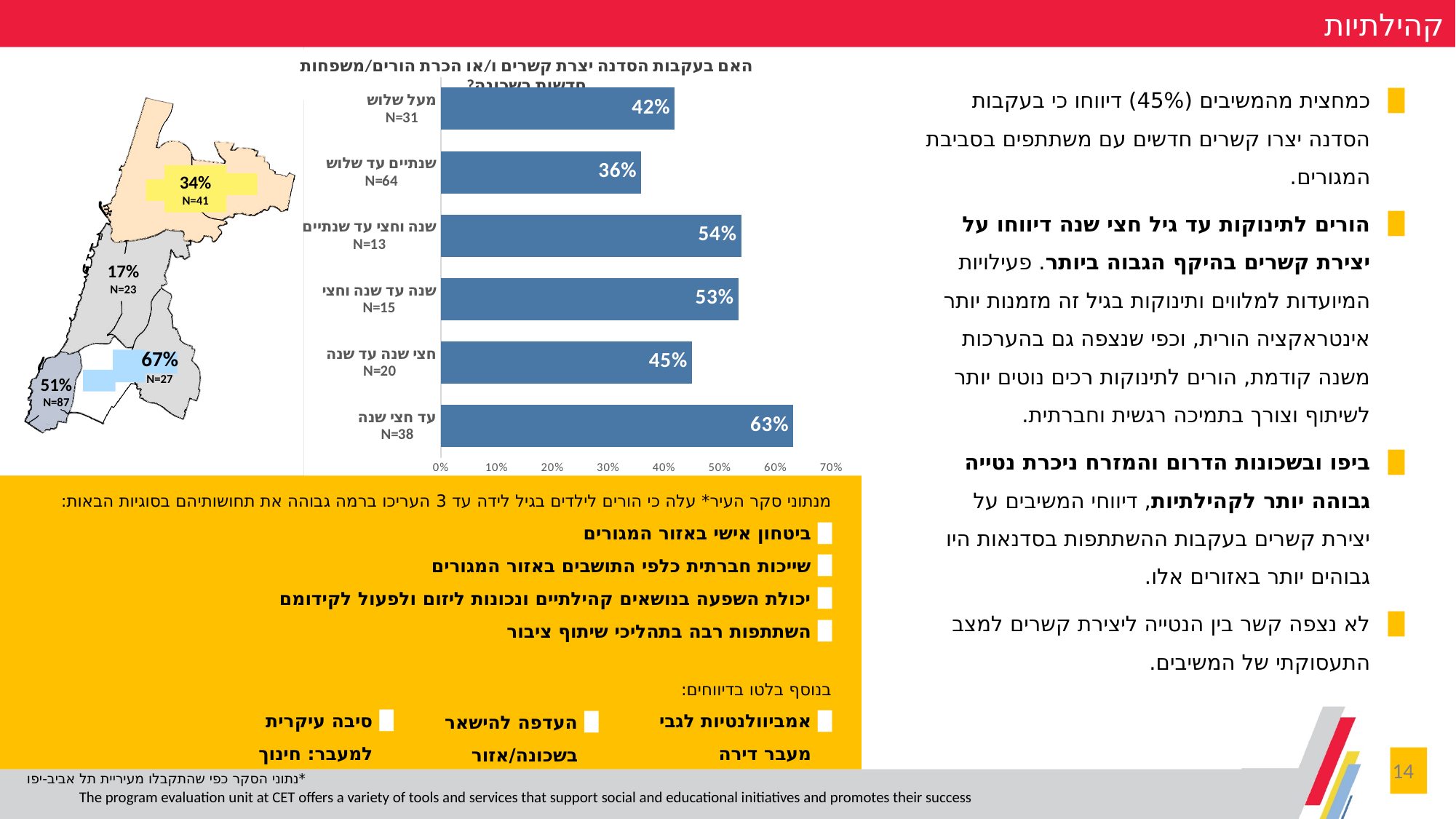
What is the value for the category 'שנתיים עד שלוש' in the bar chart? 36% Is the value for 'שנה עד שנה וחצי' greater or less than 50%? greater What type of chart is shown on the slide? bar chart Which category has the highest value in the bar chart? עד חצי שנה Which is larger in the bar chart: the value for 'שנה וחצי עד שנתיים' or the value for 'מעל שלוש'? שנה וחצי עד שנתיים What is the difference between the values for 'עד חצי שנה' and 'שנתיים עד שלוש'? 27% What is the value for the category 'מעל שלוש' in the bar chart? 42% How many age categories are shown in the bar chart? 6 What is the sample size (N) shown for the category 'שנתיים עד שלוש'? N=64 What is the value for the category 'חצי שנה עד שנה' in the bar chart? 45% What is the value for the category 'עד חצי שנה' in the bar chart? 63% Which category has the lowest value in the bar chart? שנתיים עד שלוש